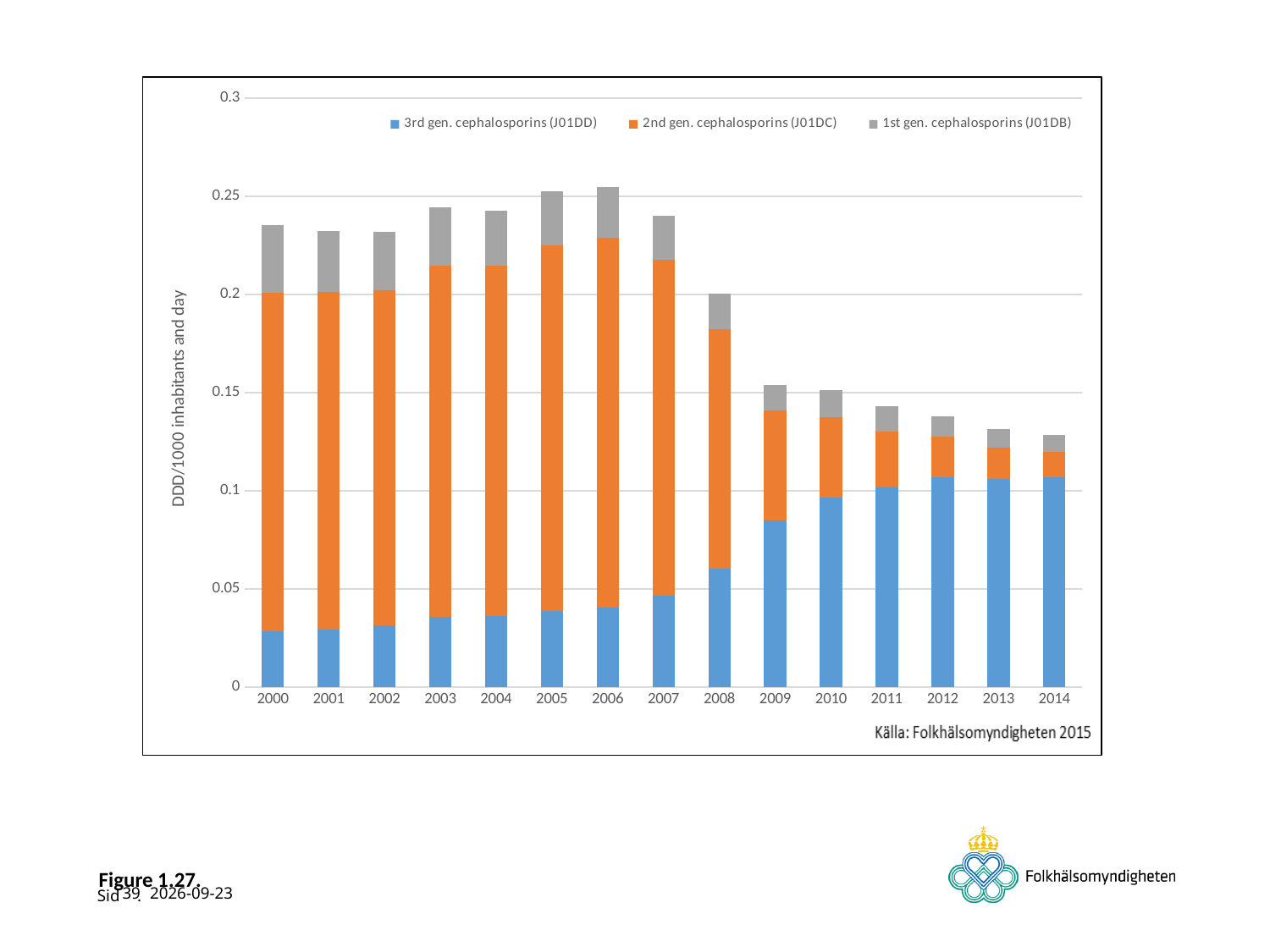
How many series does the legend list? 3 What is the label on the y axis of the chart? DDD/1000 inhabitants and day Does the 3rd gen. cephalosporins (J01DD) series rise or fall from 2000 to 2014? rise What kind of chart is shown on the slide? Stacked bar chart Is the total value for 2000 greater or less than 0.2? greater Which year has the highest total bar? 2006 Is the total value for 2011 greater or less than 0.15? less Is the value for 3rd gen. cephalosporins (J01DD) in 2000 greater or less than 0.05? less Which year has the lowest total bar? 2014 Which is larger, the total bar for 2006 or the total bar for 2014? 2006 How many years are shown on the x axis of the chart? 15